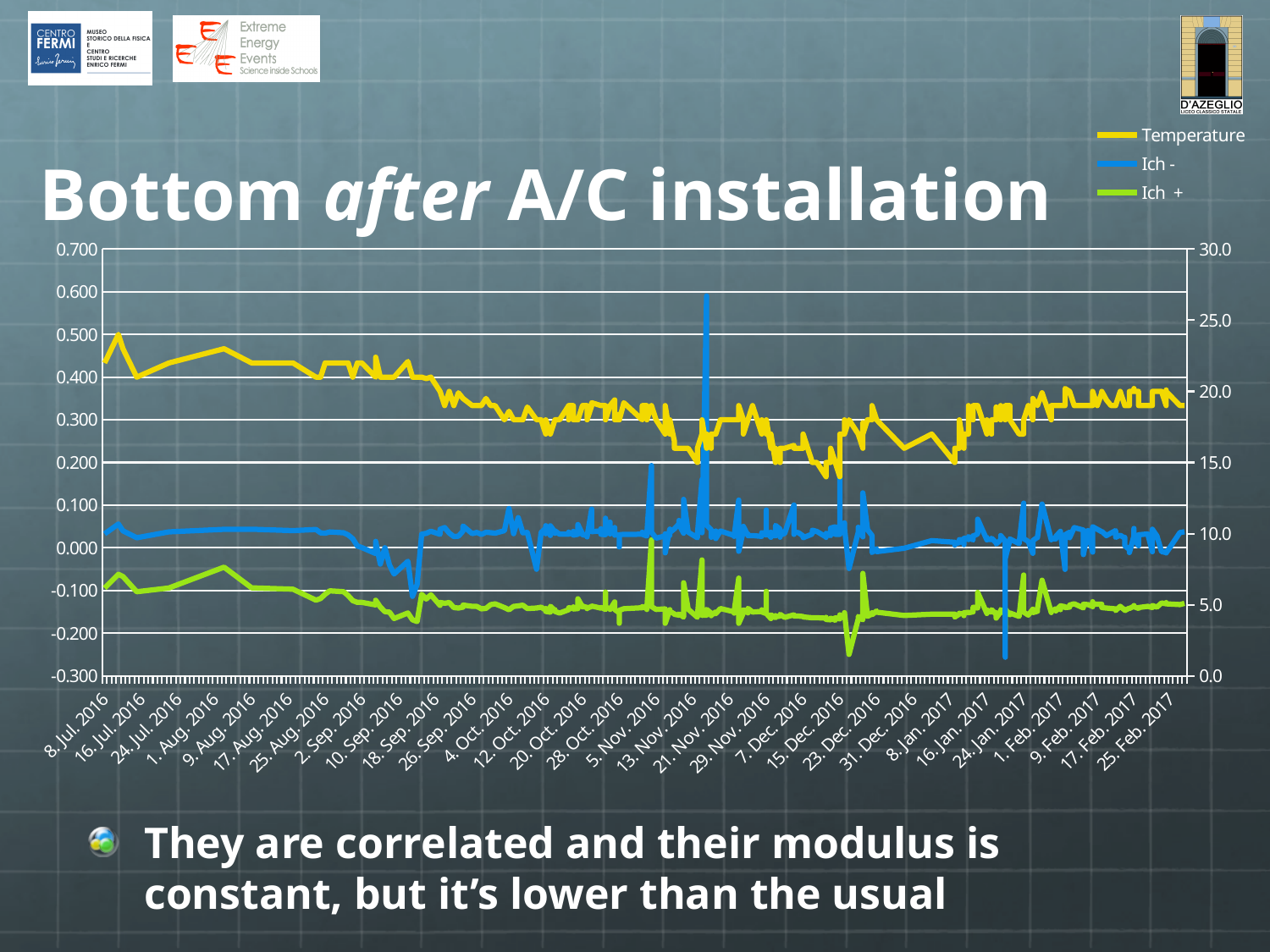
Is the Ich + value around 18. Sep. 2016 greater or less than -0.100? less What is the title of the slide containing the chart? Bottom after A/C installation Is the Ich - value at 8. Jul. 2016 greater or less than 0.000? greater What kind of chart is shown on the slide? line chart Is the Temperature value at 8. Jul. 2016 greater or less than 20.0 on the right axis? greater How many series does the legend list? 3 At 8. Jul. 2016, which is larger: Ich - or Ich +? Ich - Does the Temperature series rise or fall from 8. Jul. 2016 to 23. Dec. 2016? fall Which colour is used for the Temperature series? yellow